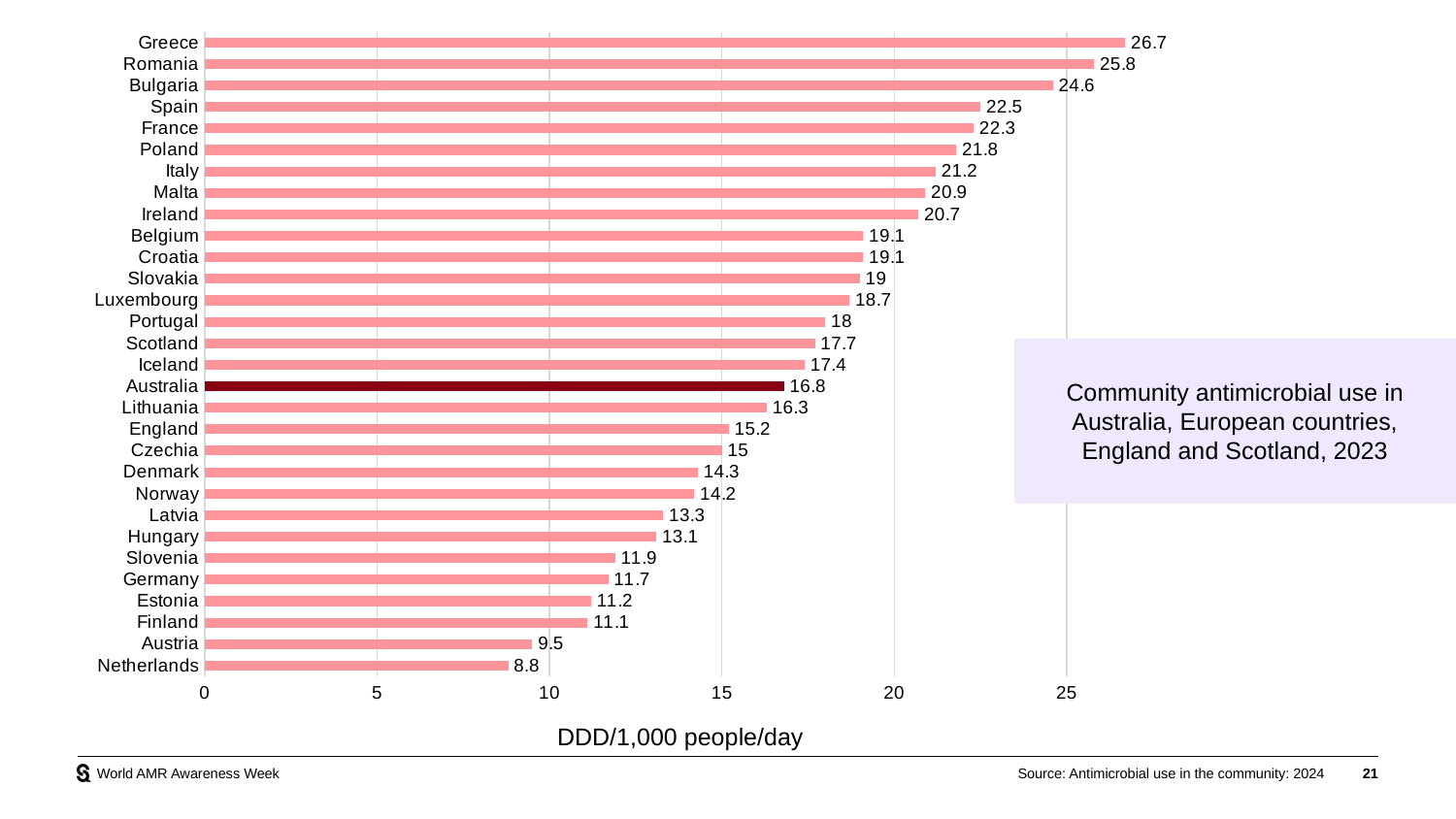
What is the value for Scotland? 17.7 What kind of chart is this? Bar chart Which country has the highest value? Greece Which is larger, the value for Spain or the value for Italy? Spain How many countries are shown in the chart? 30 What is the x-axis label of the chart? DDD/1,000 people/day What is the value for Netherlands? 8.8 What is the difference between the values for England and Scotland? 2.5 What is the value for Australia? 16.8 Which country has the lowest value? Netherlands Is the value for Bulgaria greater or less than 20? greater What is the difference between the values for Greece and Australia? 9.9